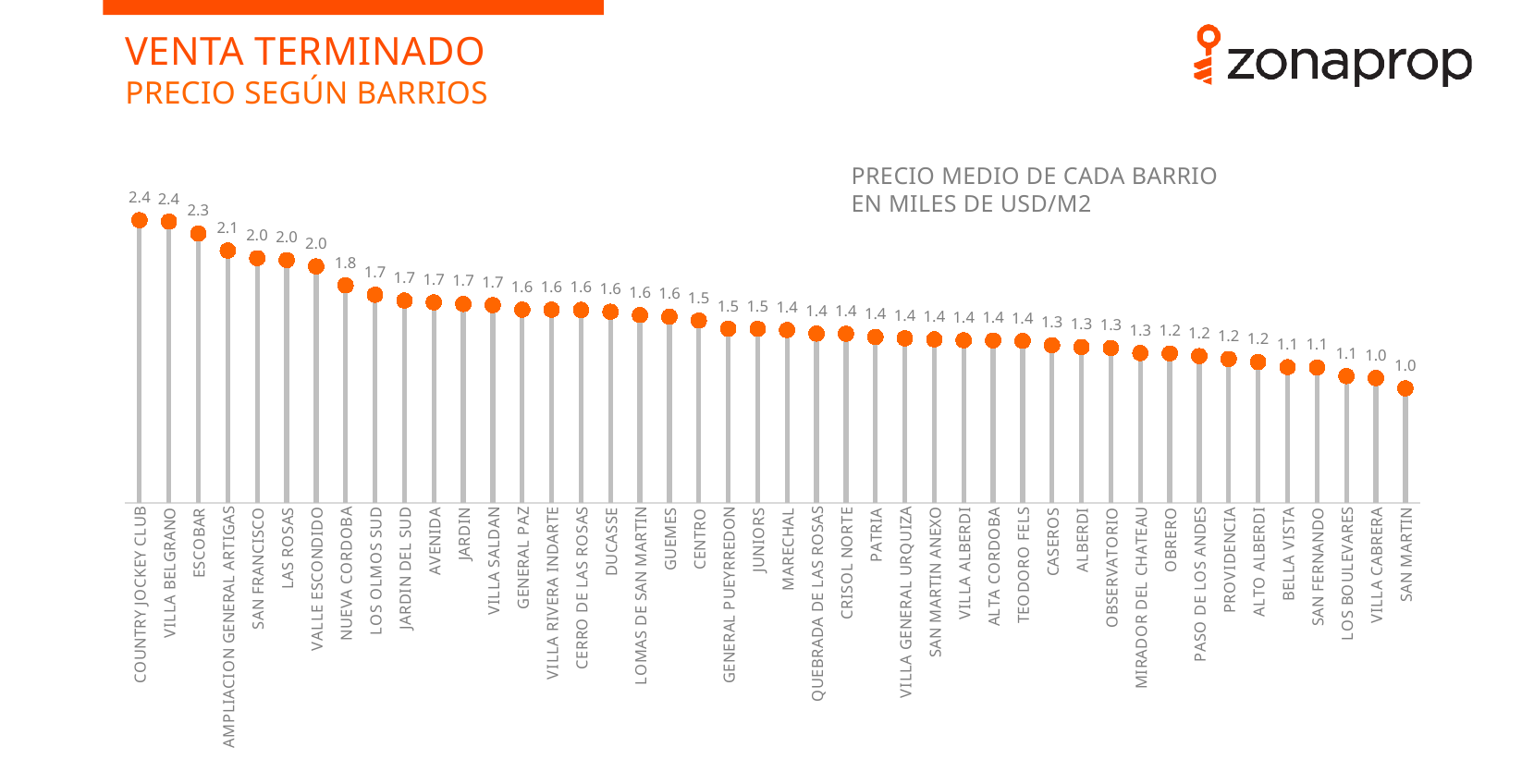
In what unit are the prices on the chart expressed, according to the chart's subtitle? miles de USD/m2 Do the values rise or fall from left to right along the x axis? fall What is the value for SAN MARTIN? 1.0 How many barrios (categories) are plotted on the chart? 44 Which has a higher value, OBRERO or VILLA SALDAN? VILLA SALDAN What is the value for ESCOBAR? 2.3 What is the value for NUEVA CORDOBA? 1.8 Which has a higher value, VALLE ESCONDIDO or GUEMES? VALLE ESCONDIDO What is the difference between the values for COUNTRY JOCKEY CLUB and SAN MARTIN? 1.4 What is the value for AMPLIACION GENERAL ARTIGAS? 2.1 What is the value for CENTRO? 1.5 What is the difference between the values for ESCOBAR and NUEVA CORDOBA? 0.5